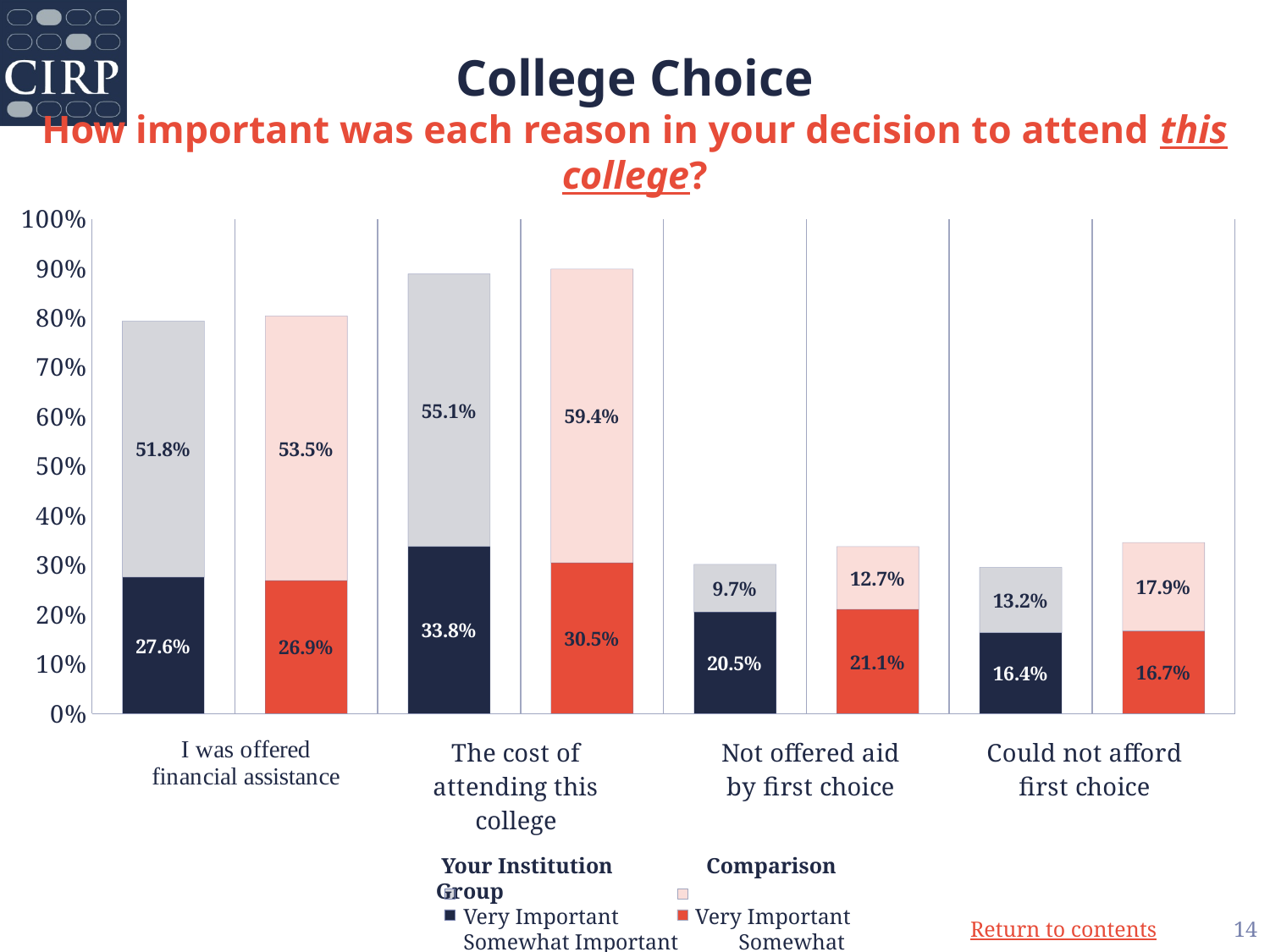
What percentage of the Comparison Group rated "I was offered financial assistance" as Somewhat Important? 53.5% What is the combined Very Important and Somewhat Important percentage for Your Institution on "I was offered financial assistance"? 79.4% What percentage of Your Institution students rated "Could not afford first choice" as Very Important? 16.4% Which reason has the lowest Somewhat Important percentage for the Comparison Group? Not offered aid by first choice What is the difference between the Comparison Group and Your Institution Somewhat Important percentages for "The cost of attending this college"? 4.3% What is the combined Very Important and Somewhat Important percentage for the Comparison Group on "Not offered aid by first choice"? 33.8% What type of chart is shown on the slide? Stacked bar chart What percentage of Your Institution students rated "The cost of attending this college" as Very Important? 33.8% For "Could not afford first choice", which group has the larger Somewhat Important percentage, Your Institution or the Comparison Group? Comparison Group Which reason has the highest Very Important percentage for Your Institution? The cost of attending this college How many reasons (categories) are shown on the x axis of the chart? 4 What percentage of the Comparison Group rated "Not offered aid by first choice" as Somewhat Important? 12.7%